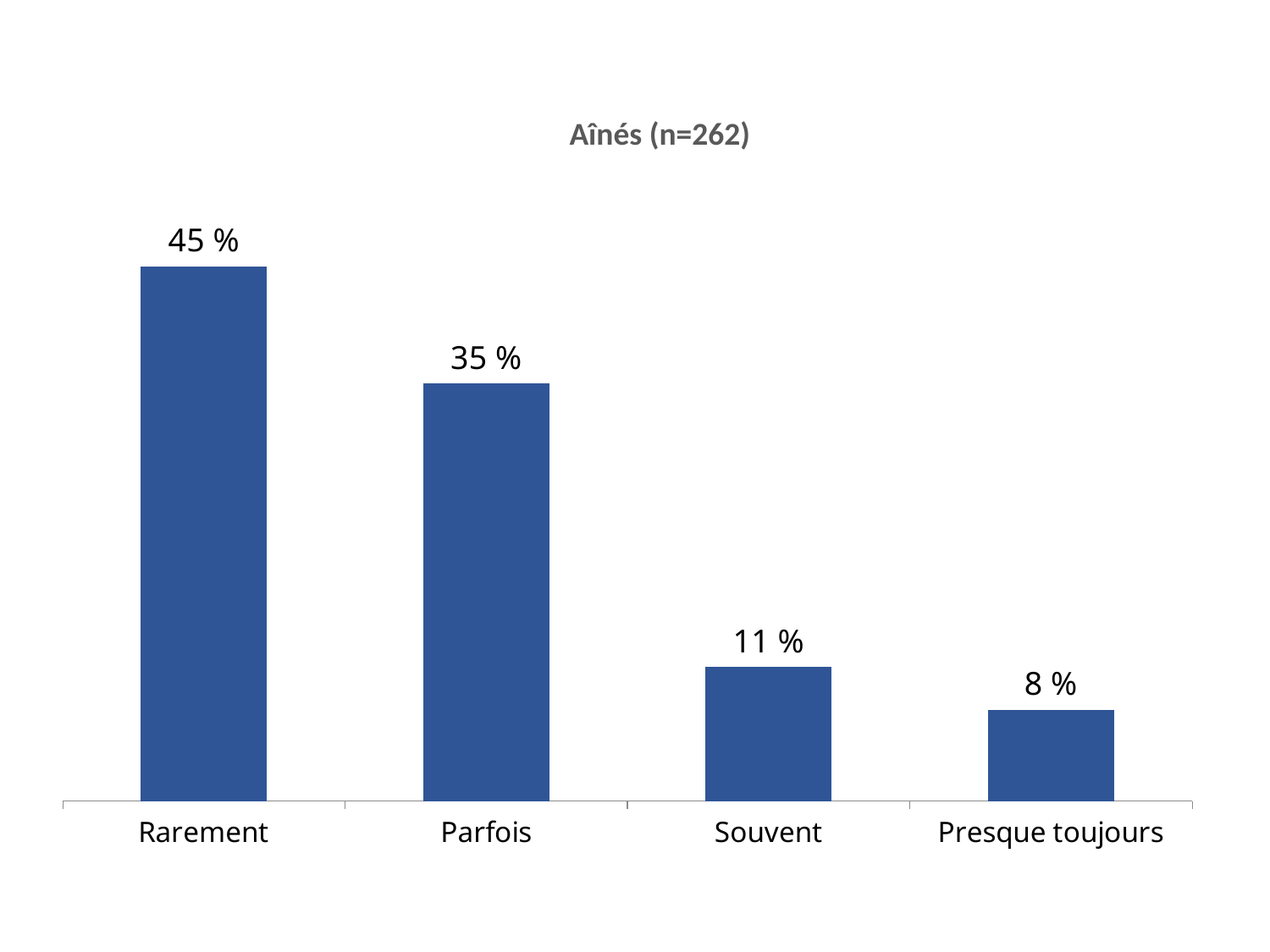
What kind of chart is this? Bar chart How many categories are shown on the x axis? 4 What is the value for Rarement? 45 % What is the difference between the values for Rarement and Parfois? 10 % Which is larger, the value for Parfois or the value for Souvent? Parfois Do the values rise or fall from left to right along the x axis? Fall Which category has the highest value? Rarement What is the difference between the values for Souvent and Presque toujours? 3 % What is the value for Presque toujours? 8 % What is the value for Souvent? 11 % What is the value for Parfois? 35 % Which category has the lowest value? Presque toujours